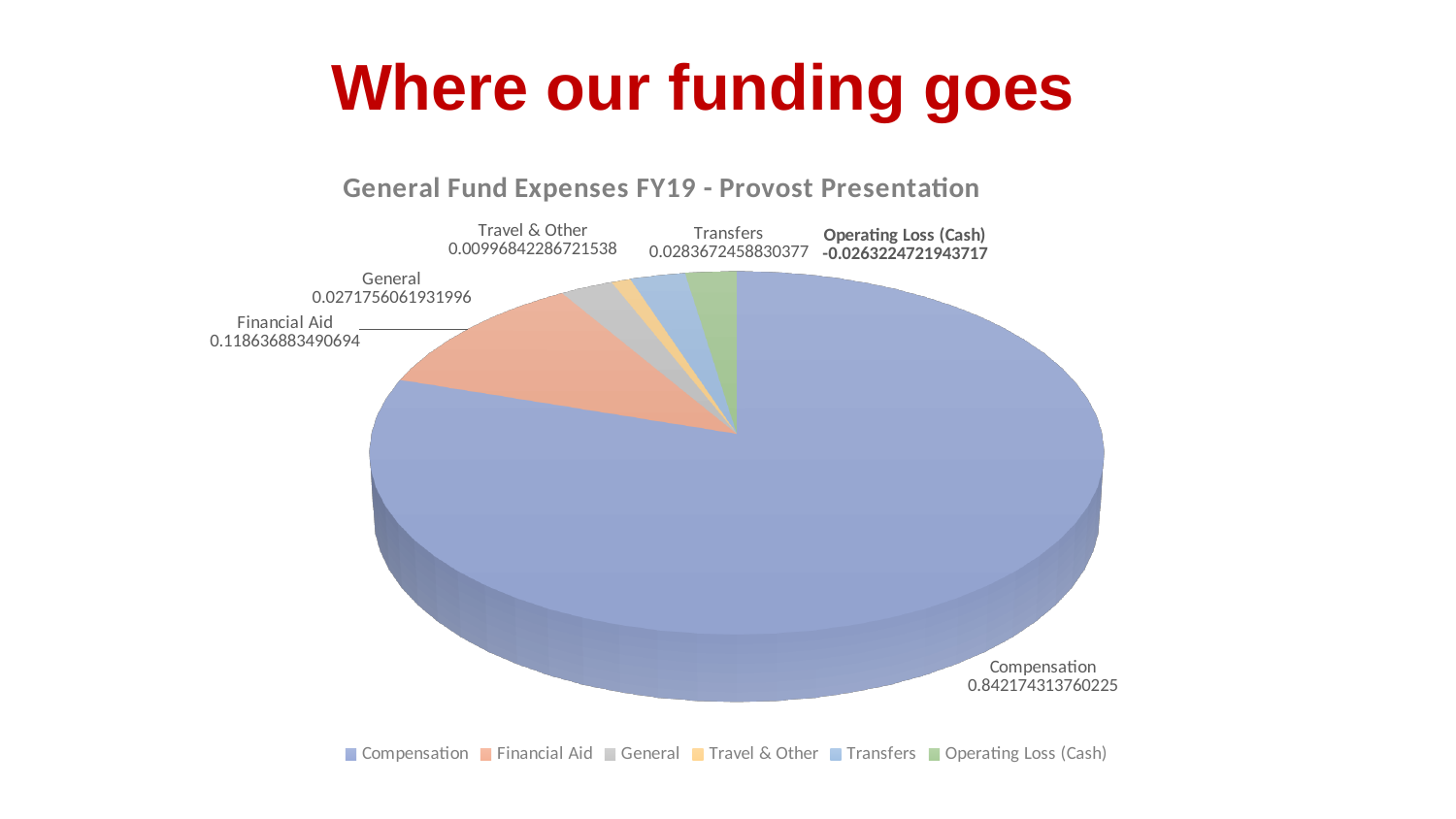
Which category has the lowest labeled value? Operating Loss (Cash) What is the value shown for Travel & Other? 0.00996842286721538 What is the value shown for Operating Loss (Cash)? -0.0263224721943717 How many entries does the legend list? 6 Which category has the largest share of the pie? Compensation How many categories are shown in the pie chart? 6 What is the value shown for Transfers? 0.0283672458830377 What type of chart is shown on the slide? Pie chart What is the value shown for Compensation? 0.842174313760225 What is the value shown for Financial Aid? 0.118636883490694 What is the title of the chart? General Fund Expenses FY19 - Provost Presentation Which is larger, the value for Financial Aid or the value for General? Financial Aid